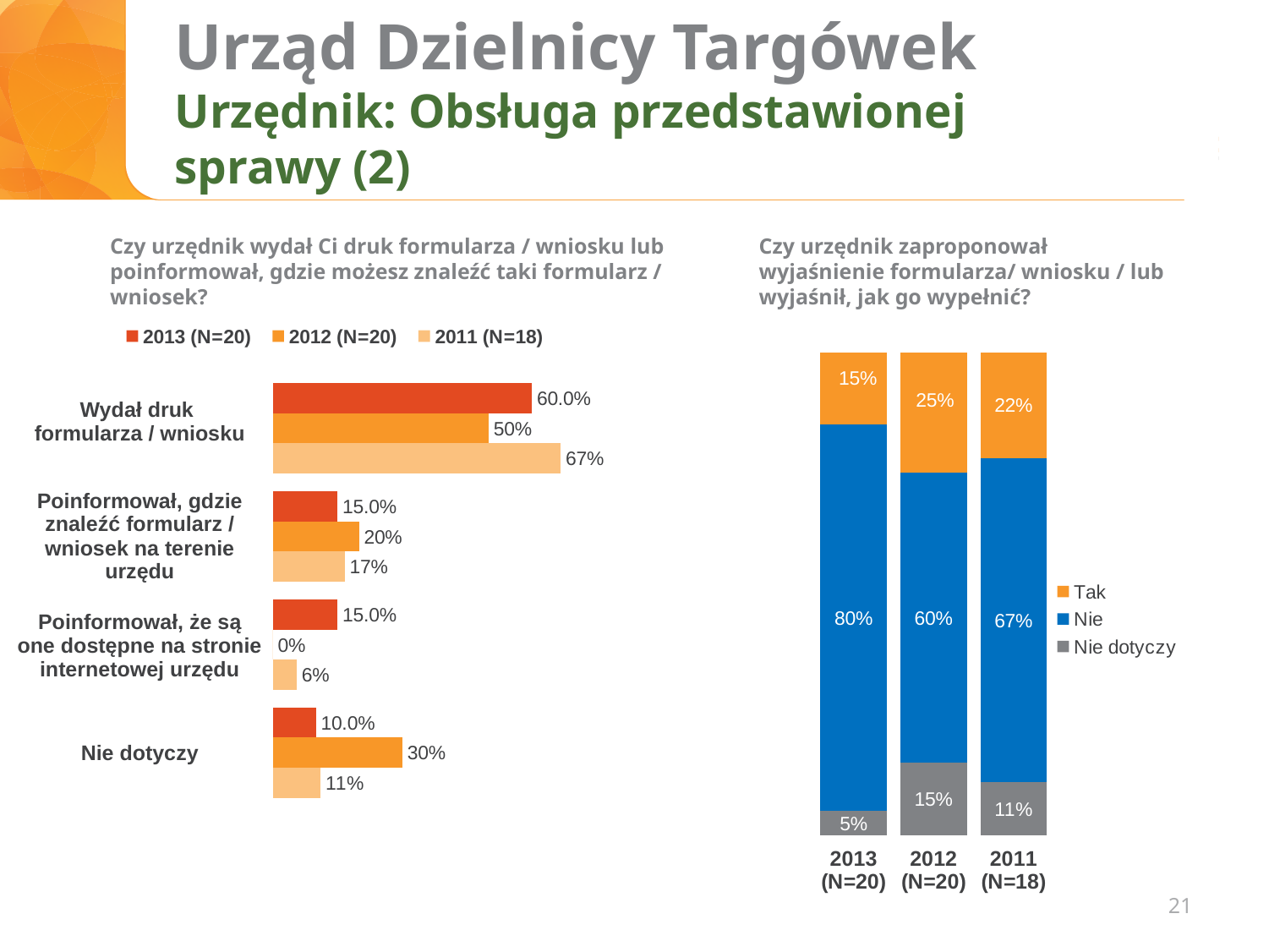
In the left chart, what is the 2012 (N=20) value for 'Nie dotyczy'? 30% In the left chart, what is the 2013 (N=20) value for 'Wydał druk formularza / wniosku'? 60.0% In the left chart, how many categories are shown? 4 In the left chart, what is the 2012 (N=20) value for 'Poinformował, że są one dostępne na stronie internetowej urzędu'? 0% What type of chart is the right chart? Stacked bar chart In the left chart, what is the 2011 (N=18) value for 'Wydał druk formularza / wniosku'? 67% In the right chart, what is the 'Tak' value for 2012 (N=20)? 25% In the left chart, how many series does the legend list? 3 In the right chart, which year has the lowest 'Nie dotyczy' value? 2013 (N=20) In the left chart, which category has the highest 2013 (N=20) value? Wydał druk formularza / wniosku In the right chart, what is the 'Nie' value for 2013 (N=20)? 80% In the left chart, what is the difference between the 2011 (N=18) and 2012 (N=20) values for 'Wydał druk formularza / wniosku'? 17 percentage points